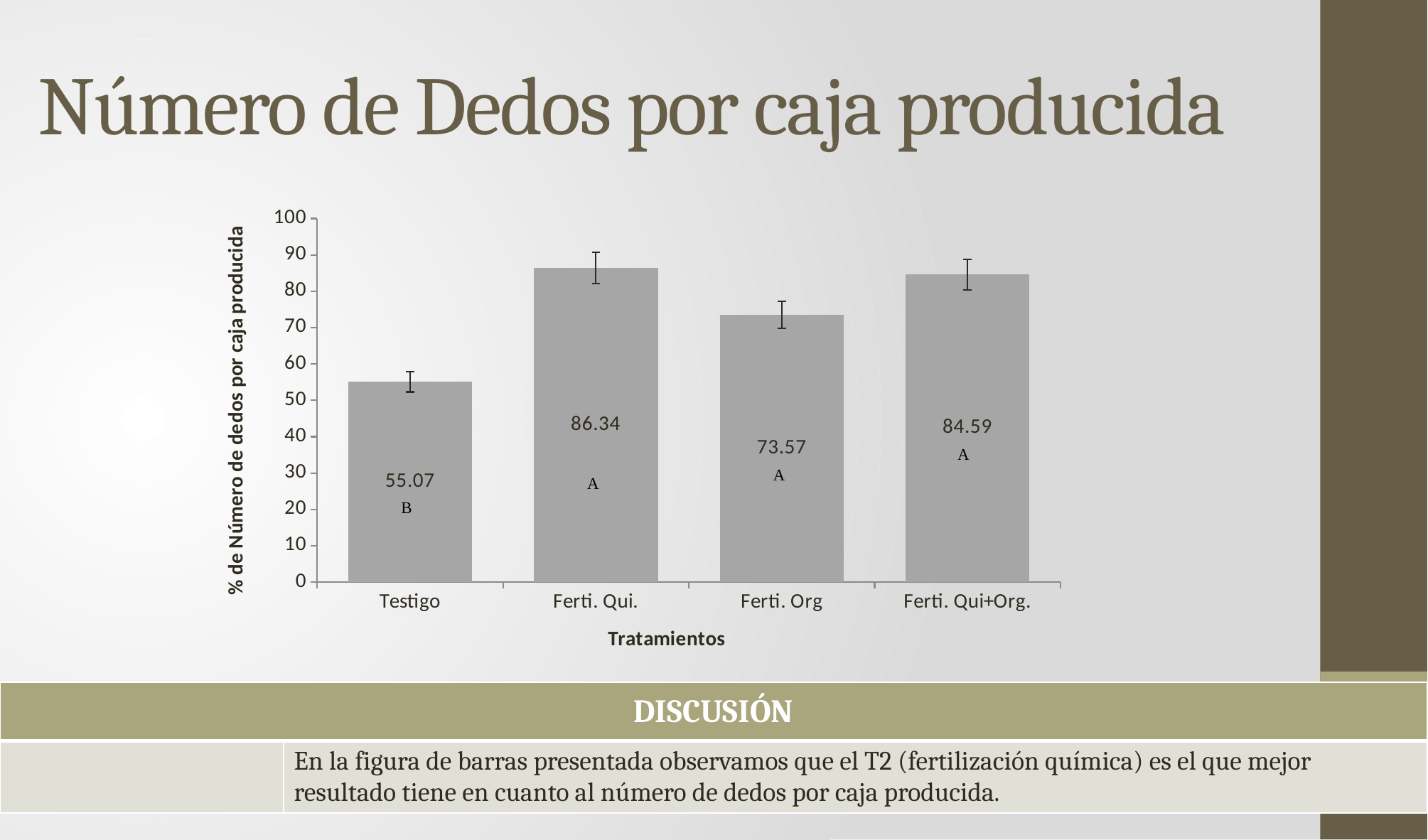
Is the value for Testigo greater or less than 60? less What is the value for Ferti. Org? 73.57 Which treatment has the lowest value? Testigo What is the difference between the values for Ferti. Qui. and Testigo? 31.27 What is the label of the x axis? Tratamientos What is the value for Ferti. Qui.? 86.34 What is the value for Ferti. Qui+Org.? 84.59 What is the value for Testigo? 55.07 Which treatment has the highest value? Ferti. Qui. What kind of chart is shown on the slide? bar chart Which is larger, the value for Ferti. Org or the value for Ferti. Qui+Org.? Ferti. Qui+Org. How many treatments are shown on the x axis? 4